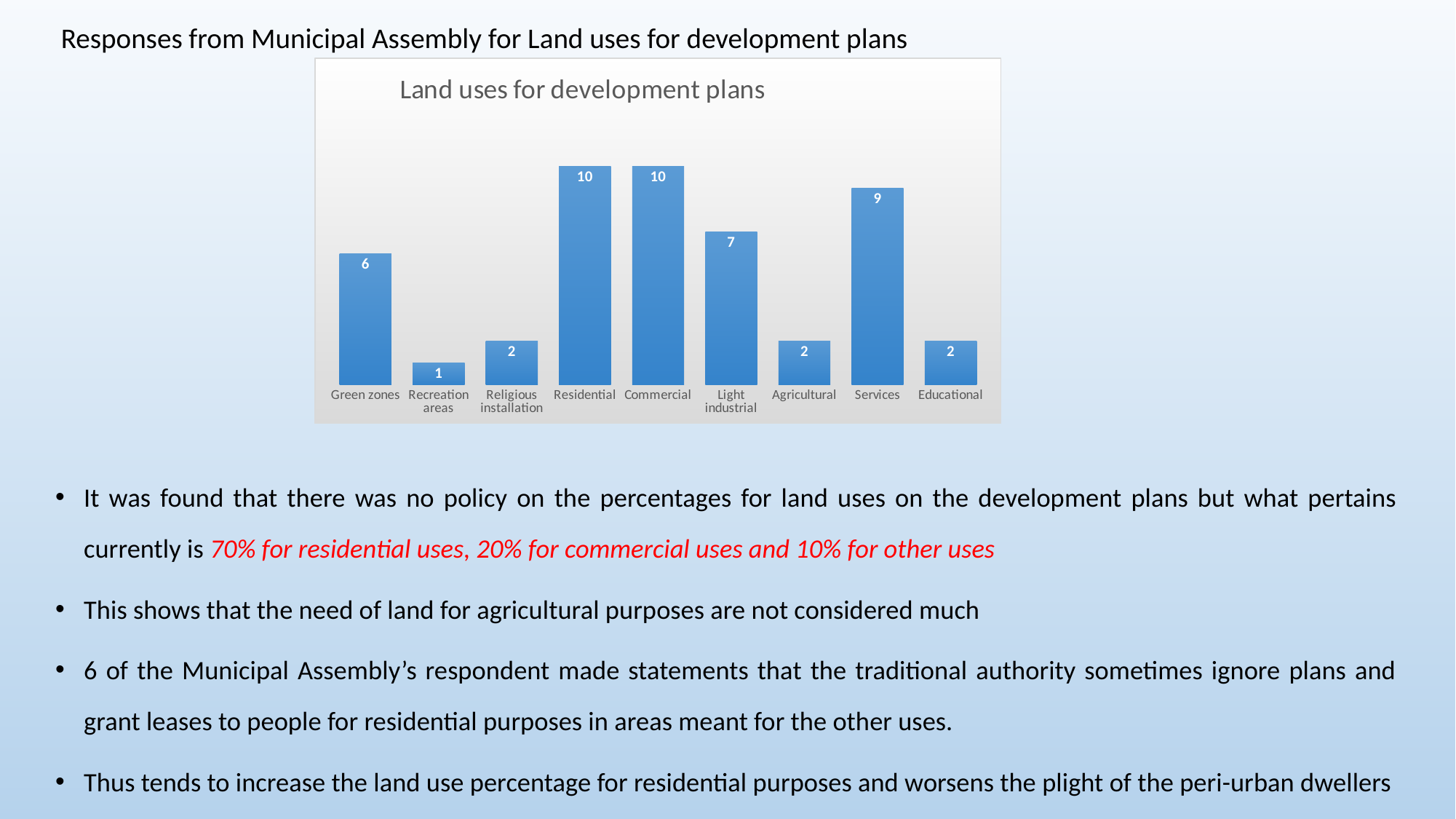
What is the value for Light industrial? 7 How many categories are shown on the x axis? 9 What is the title of the chart? Land uses for development plans What is the value for Services? 9 Which is larger, the value for Green zones or the value for Light industrial? Light industrial What kind of chart is shown? Bar chart What is the value for Green zones? 6 What is the difference between the values for Services and Light industrial? 2 Which category has the lowest value? Recreation areas What is the difference between the values for Residential and Green zones? 4 Which is larger, the value for Agricultural or the value for Recreation areas? Agricultural Which categories share the highest value? Residential and Commercial